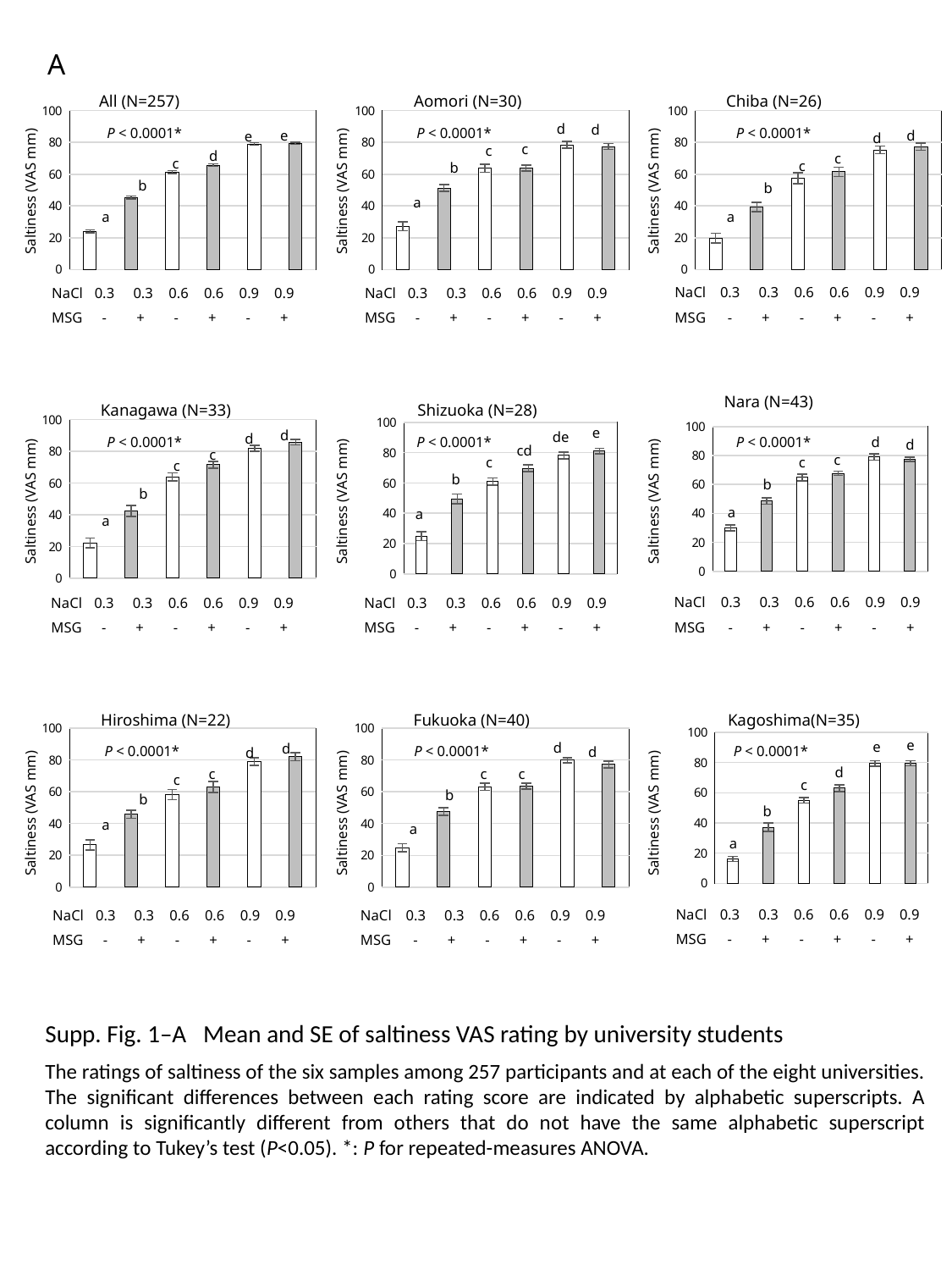
How many charts are shown on the slide? 9 What is the y-axis label on the "Shizuoka (N=28)" chart? Saltiness (VAS mm) In the "All (N=257)" chart, is the value for NaCl 0.3 without MSG greater or less than 40? less In the "Shizuoka (N=28)" chart, is the value for NaCl 0.6 without MSG greater or less than 40? greater In the "Kanagawa (N=33)" chart, which is larger: the rating for NaCl 0.6 with MSG or NaCl 0.9 without MSG? NaCl 0.9 without MSG In the "Kagoshima(N=35)" chart, is the value for NaCl 0.9 with MSG greater or less than 60? greater In the "Hiroshima (N=22)" chart, which is larger: the rating for NaCl 0.3 with MSG or NaCl 0.3 without MSG? NaCl 0.3 with MSG In the "Nara (N=43)" chart, do the saltiness ratings rise or fall as the NaCl concentration increases from 0.3 to 0.9? rise What P value is printed on the "Fukuoka (N=40)" chart? P < 0.0001* In the "Chiba (N=26)" chart, which sample has the lowest saltiness rating? NaCl 0.3 without MSG (MSG -) In the "Aomori (N=30)" chart, how many bars are plotted? 6 What kind of chart is the "All (N=257)" chart? bar chart